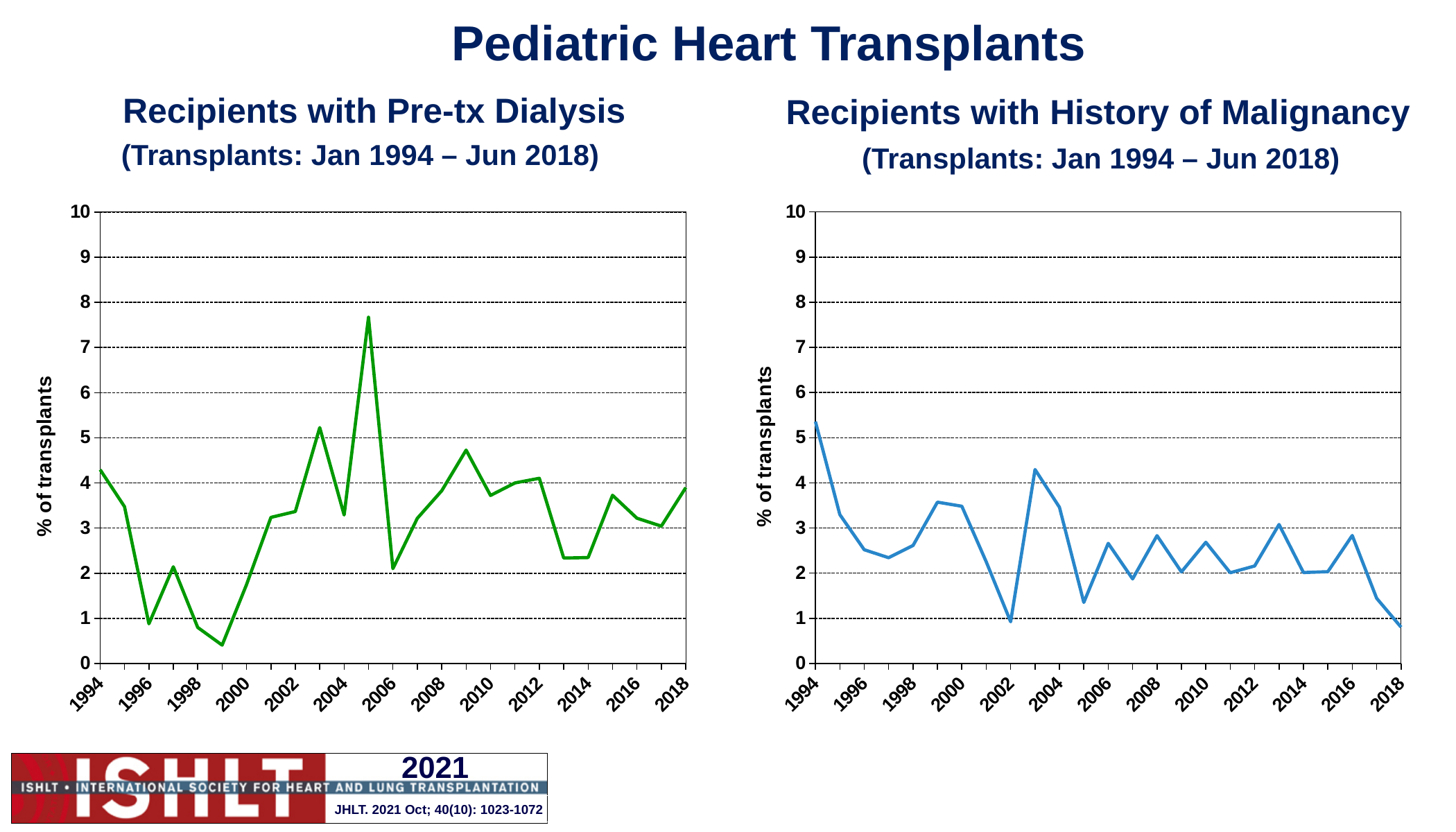
In the 'Recipients with History of Malignancy' chart, which is larger, the value for 1994 or the value for 2018? 1994 In the 'Recipients with History of Malignancy' chart, which year has the highest value? 1994 In the 'Recipients with Pre-tx Dialysis' chart, is the value for 2005 greater or less than 7? greater In the 'Recipients with History of Malignancy' chart, is the value for 1994 greater or less than 5? greater In the 'Recipients with Pre-tx Dialysis' chart, is the value for 1999 greater or less than 1? less In the 'Recipients with Pre-tx Dialysis' chart, which year has the highest value? 2005 What is the y-axis label on the 'Recipients with History of Malignancy' chart? % of transplants What kind of chart is the 'Recipients with Pre-tx Dialysis' chart on the left? line chart In the 'Recipients with Pre-tx Dialysis' chart, which is larger, the value for 2003 or the value for 2005? 2005 In the 'Recipients with History of Malignancy' chart, does the value overall rise or fall from 1994 to 2018? fall In the 'Recipients with Pre-tx Dialysis' chart, which year has the lowest value? 1999